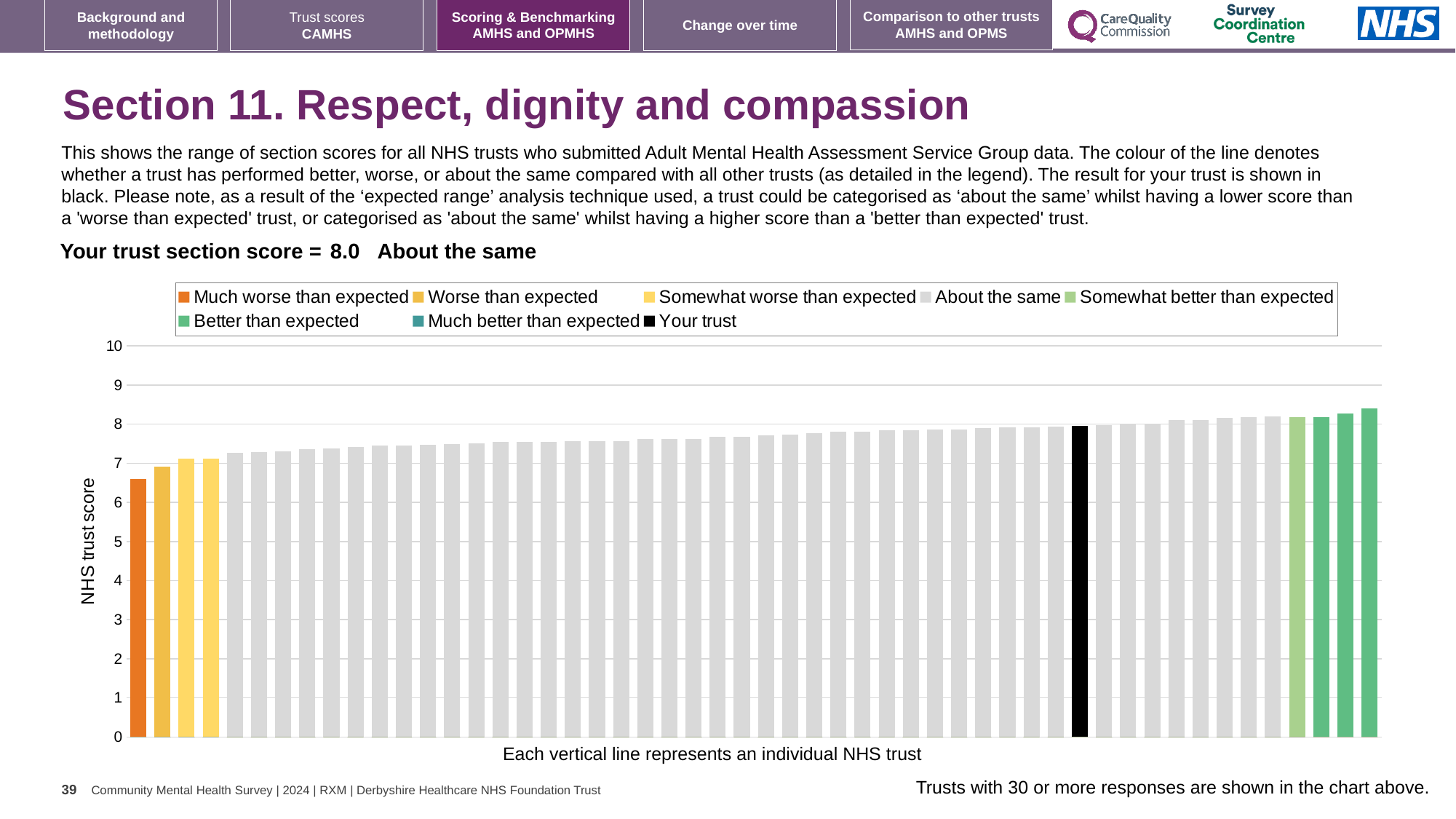
How many entries does the chart legend list? 8 Do the bar values rise or fall from left to right along the x axis? Rise Which legend category does your trust's score fall into? About the same What is the label on the vertical axis of the chart? NHS trust score Is the value of the highest bar on the chart greater or less than 8? greater How many bars are coloured as 'Much worse than expected'? 1 Which is larger: the black 'Your trust' bar or the orange 'Much worse than expected' bar? Your trust What kind of chart is shown on the slide? Bar chart Is the value for your trust (the black bar) greater or less than 7? greater What is the section score for your trust shown on the slide? 8.0 What colour is used for the 'Your trust' bar in the chart? Black Is the value of the lowest bar (the orange 'Much worse than expected' bar) greater or less than 7? less